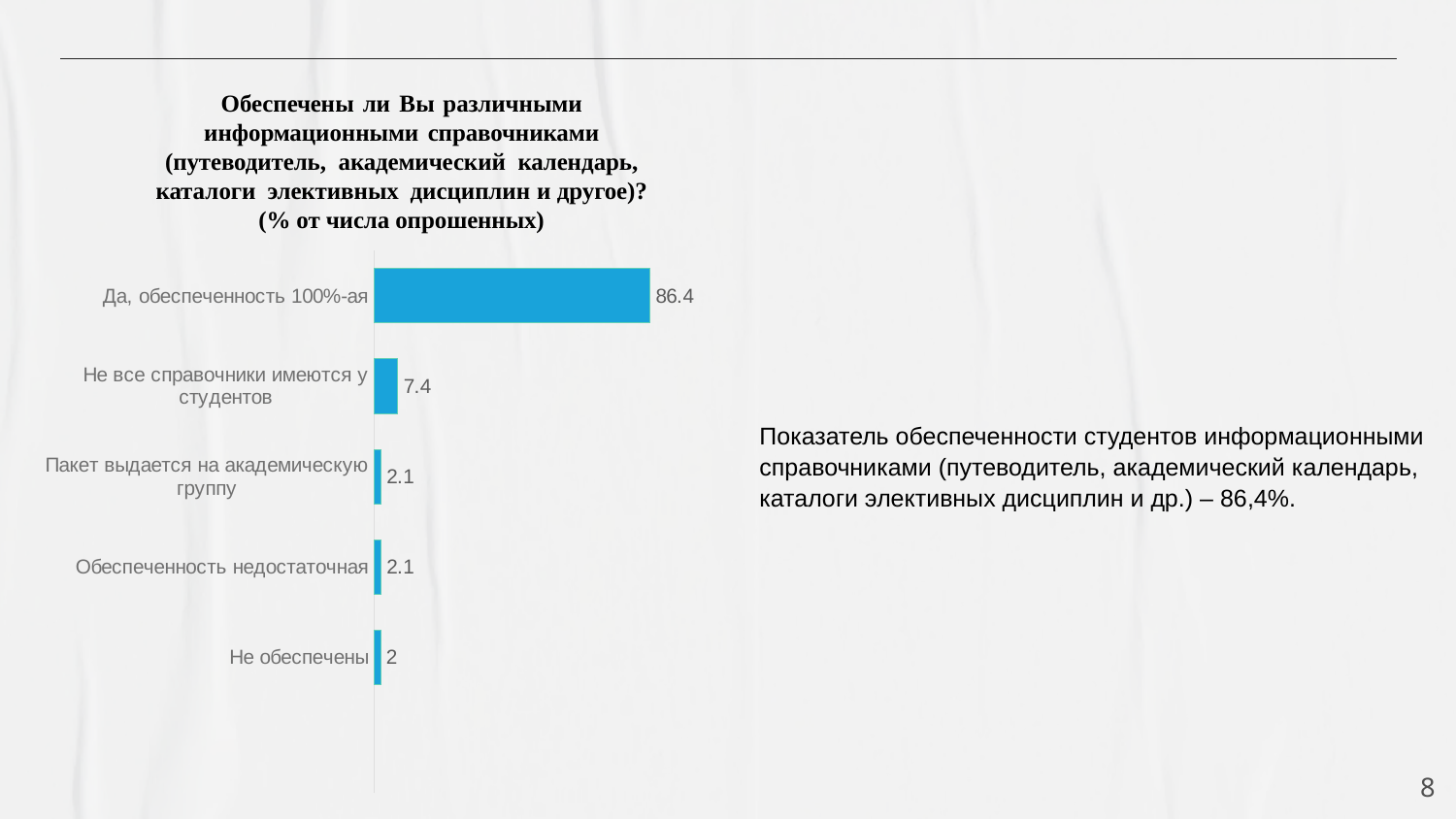
Which is larger: the value for "Не все справочники имеются у студентов" or for "Обеспеченность недостаточная"? Не все справочники имеются у студентов What colour are the bars in the chart? Blue What is the value for "Не все справочники имеются у студентов"? 7.4 What is the value for "Пакет выдается на академическую группу"? 2.1 How many categories are shown in the chart? 5 What is the value for "Да, обеспеченность 100%-ая"? 86.4 What is the difference between the values for "Да, обеспеченность 100%-ая" and "Не все справочники имеются у студентов"? 79 What kind of chart is shown on the slide? Bar chart What is the difference between the values for "Обеспеченность недостаточная" and "Не обеспечены"? 0.1 What is the value for "Не обеспечены"? 2 Which category has the highest value? Да, обеспеченность 100%-ая Which category has the lowest value? Не обеспечены